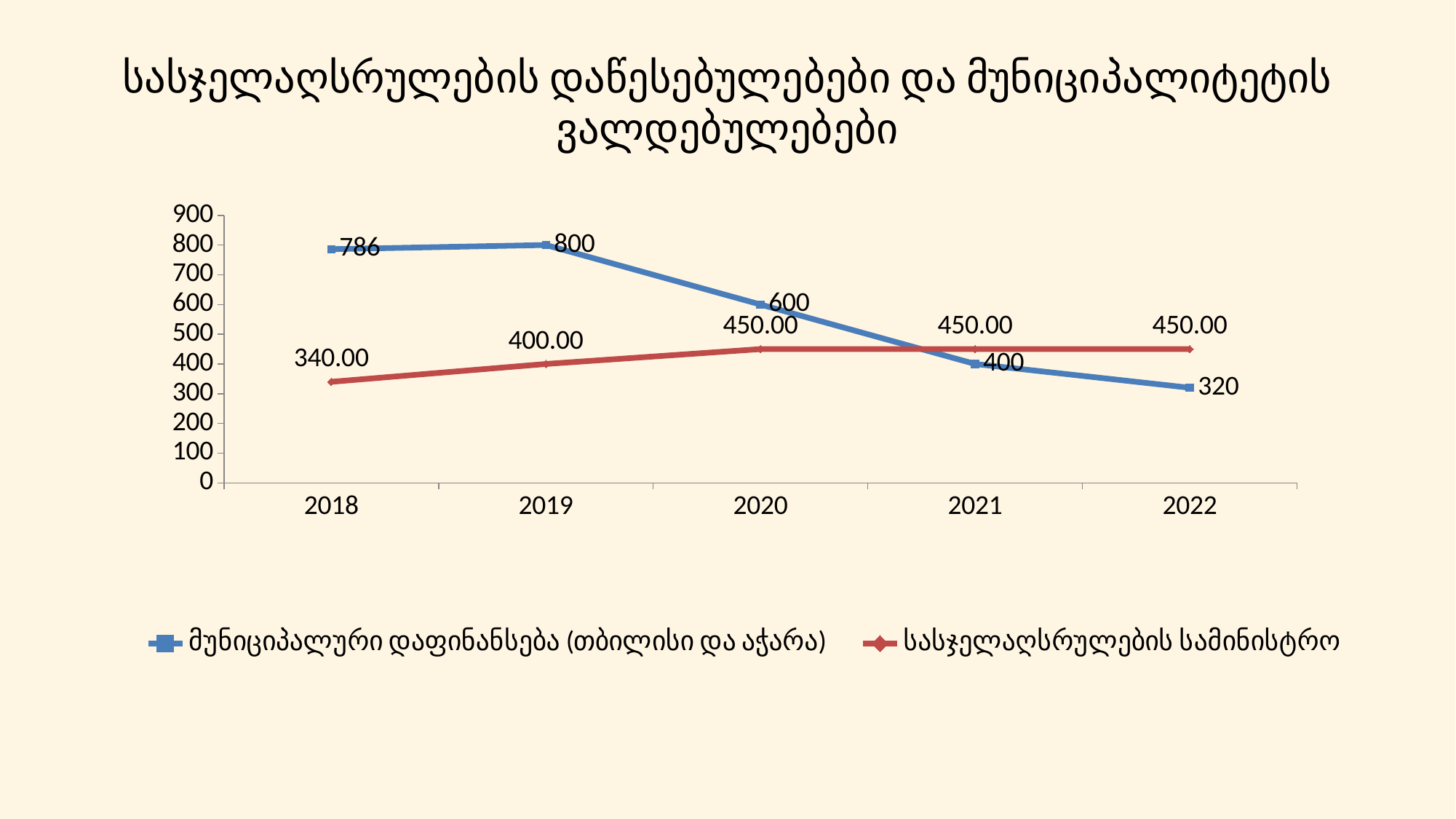
What is the value of the სასჯელაღსრულების სამინისტრო series in 2018? 340.00 What kind of chart is shown on the slide? line chart How many series does the legend list? 2 Is the value of the მუნიციპალური დაფინანსება (თბილისი და აჭარა) series in 2020 greater or less than 500? greater What is the difference between the მუნიციპალური დაფინანსება (თბილისი და აჭარა) values in 2019 and 2022? 480 In which year is the სასჯელაღსრულების სამინისტრო series lowest? 2018 What is the value of the მუნიციპალური დაფინანსება (თბილისი და აჭარა) series in 2022? 320 What is the value of the მუნიციპალური დაფინანსება (თბილისი და აჭარა) series in 2019? 800 In 2021, which series has the larger value: მუნიციპალური დაფინანსება (თბილისი და აჭარა) or სასჯელაღსრულების სამინისტრო? სასჯელაღსრულების სამინისტრო Does the მუნიციპალური დაფინანსება (თბილისი და აჭარა) series rise or fall from 2019 to 2022? fall In which year is the მუნიციპალური დაფინანსება (თბილისი და აჭარა) series highest? 2019 How many years are shown on the x axis? 5